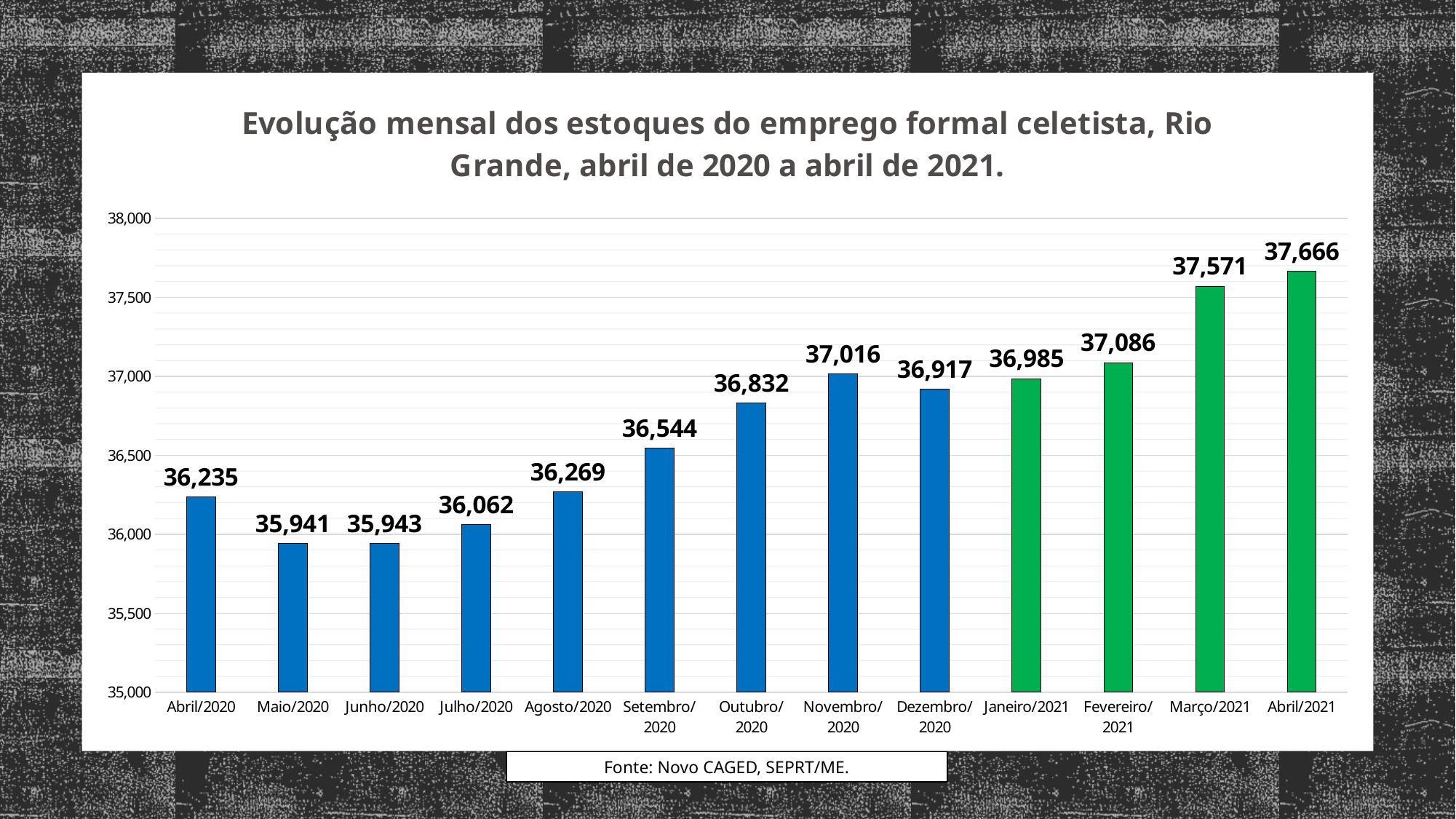
How many months are shown on the x axis? 13 What is the difference between the values for Novembro/2020 and Dezembro/2020? 99 What colour are the bars for the 2021 months? green What is the value for Abril/2020? 36,235 What is the value for Fevereiro/2021? 37,086 What is the difference between the values for Abril/2021 and Abril/2020? 1,431 Which is larger, the value for Dezembro/2020 or the value for Janeiro/2021? Janeiro/2021 What is the value for Novembro/2020? 37,016 Which month has the highest value? Abril/2021 Which month has the lowest value? Maio/2020 Is the value for Outubro/2020 greater or less than 37,000? less What kind of chart is shown on the slide? bar chart